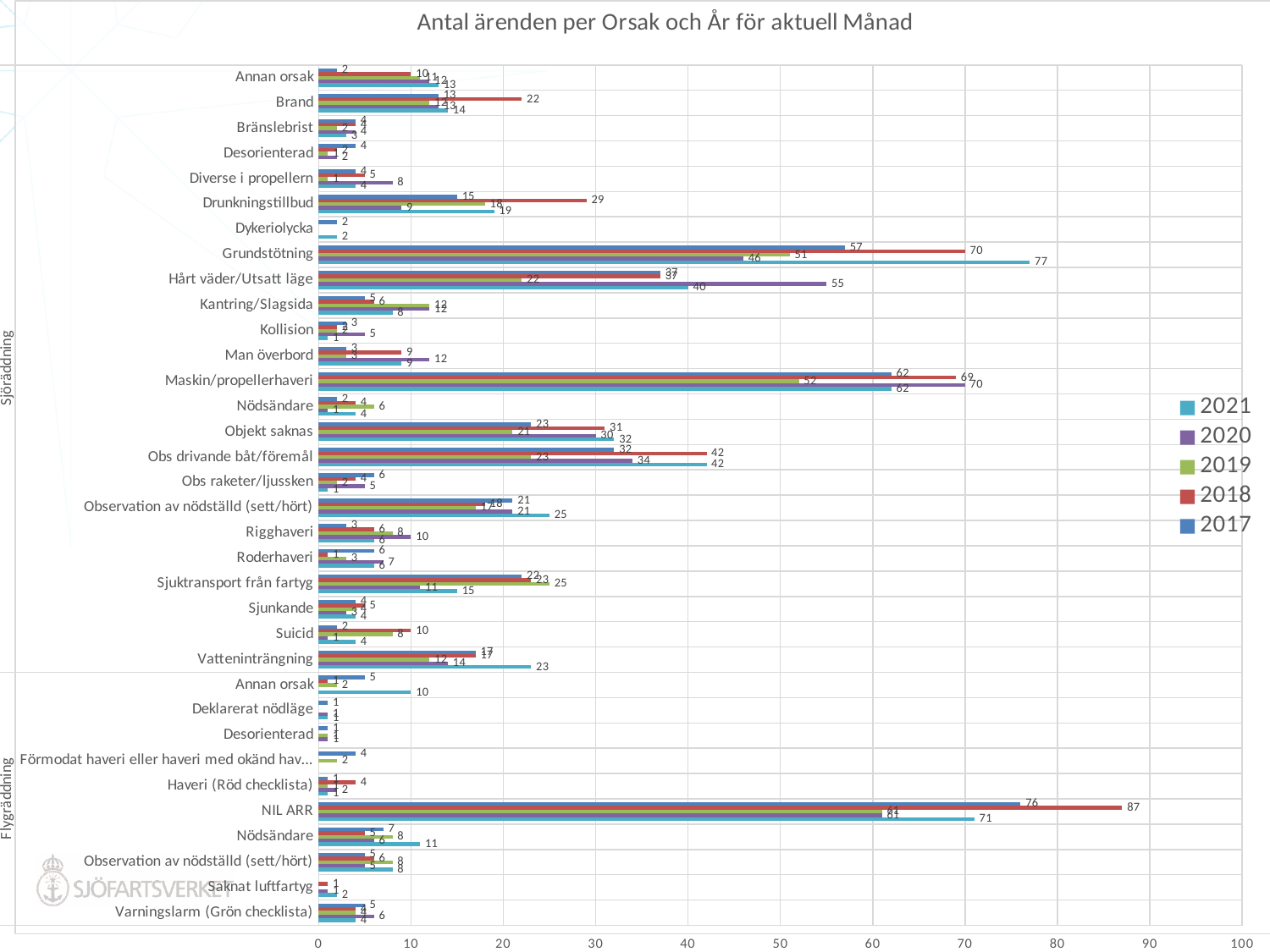
Which is larger for Drunkningstillbud, the 2018 value or the 2021 value? 2018 What is the value for NIL ARR in 2018? 87 Is the value for NIL ARR in 2021 greater or less than 60? greater What is the title of the chart? Antal ärenden per Orsak och År för aktuell Månad Which year has the highest value for Grundstötning? 2021 Which year has the lowest value for Drunkningstillbud? 2020 What is the value for Hårt väder/Utsatt läge in 2020? 55 What is the value for Grundstötning in 2021? 77 How many series does the legend list? 5 What is the value for Drunkningstillbud in 2018? 29 What is the difference between the 2018 and 2020 values for Grundstötning? 24 What type of chart is shown on the slide? bar chart